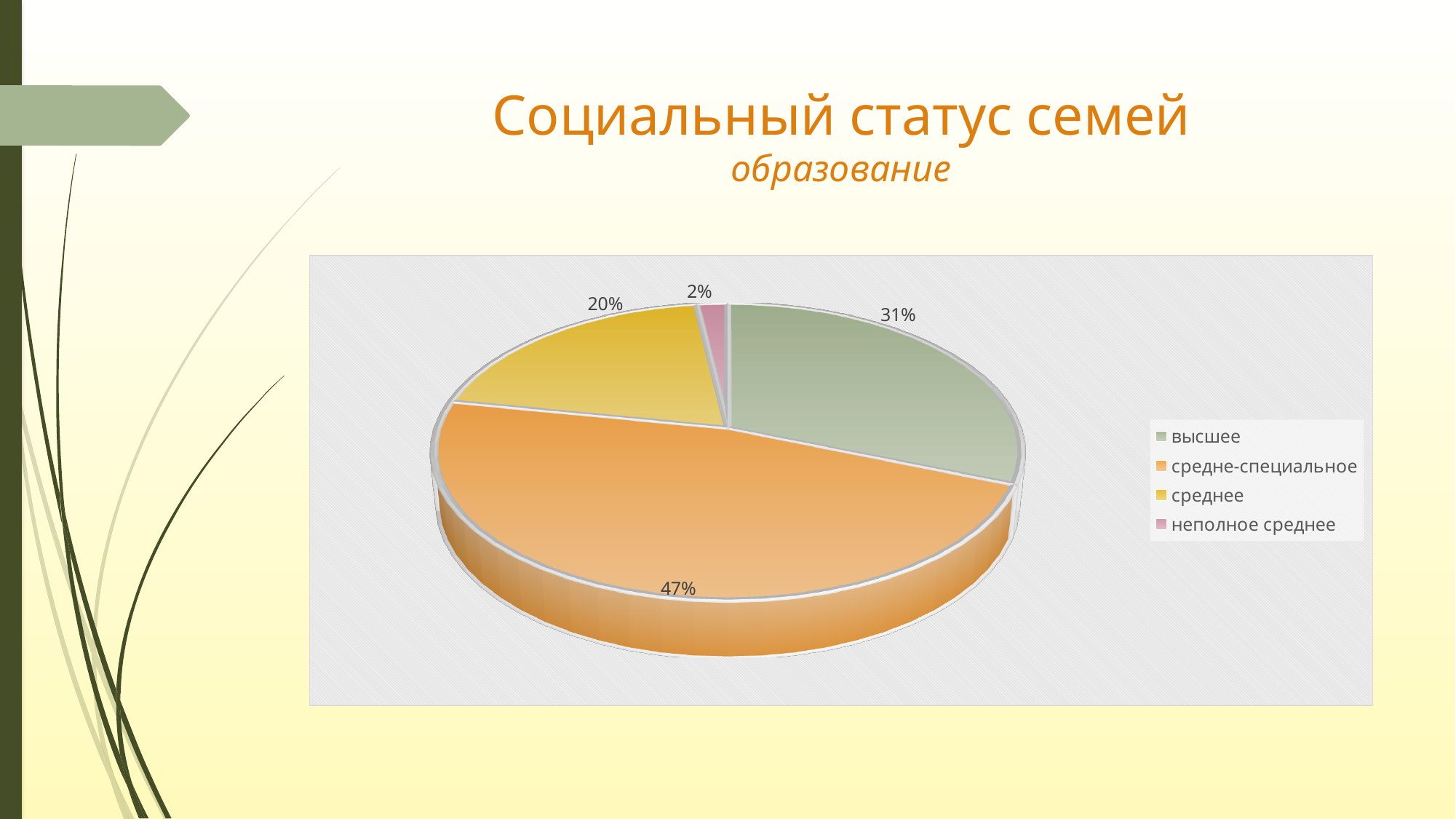
What kind of chart is shown on the slide? pie chart What share of the pie does среднее have? 20% How many categories does the pie chart have? 4 What is the difference between the shares for средне-специальное and высшее? 16% Which category has the largest slice of the pie? средне-специальное What share of the pie does средне-специальное have? 47% What share of the pie does неполное среднее have? 2% What share of the pie does высшее have? 31% Which is larger, the share for высшее or the share for среднее? высшее What colour is the slice for средне-специальное? orange Which category has the smallest slice of the pie? неполное среднее What is the combined share of среднее and неполное среднее? 22%